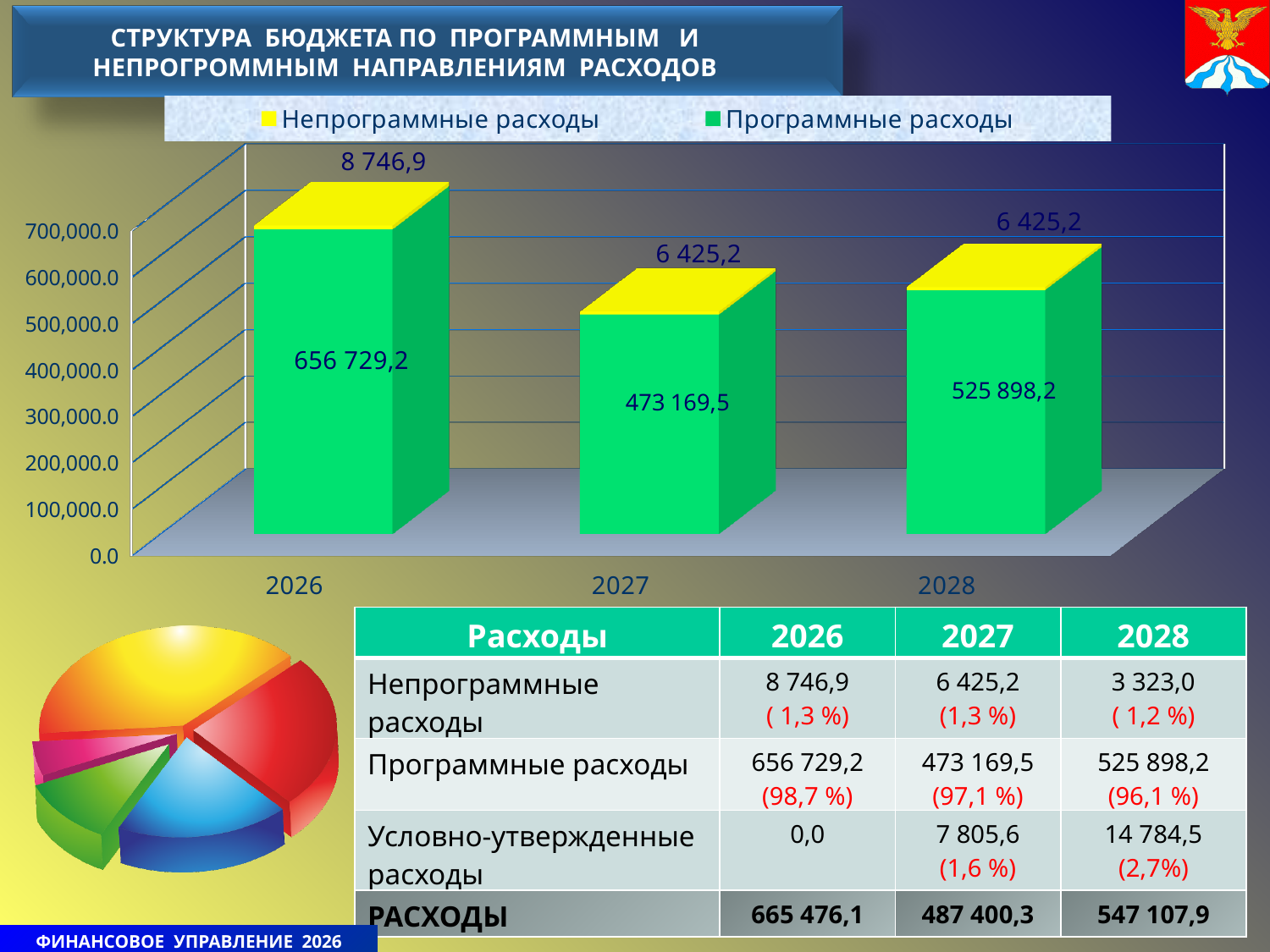
Is the value of Программные расходы for 2027 greater or less than 500,000.0? less What is the difference between Программные расходы in 2026 and 2027 in the bar chart? 183 559,7 What type of chart is shown at the top of the slide? bar chart Which is larger in the bar chart: Программные расходы in 2028 or in 2027? 2028 What is the value of Непрограммные расходы for 2026 in the bar chart? 8 746,9 How many years (categories) are shown on the x axis of the bar chart? 3 In which year is Программные расходы the highest in the bar chart? 2026 What is the value of Программные расходы for 2026 in the bar chart? 656 729,2 What is the value of Программные расходы for 2027 in the bar chart? 473 169,5 In which year is Программные расходы the lowest in the bar chart? 2027 How many series does the legend of the bar chart list? 2 What is the total of the stacked bar for 2026 in the bar chart? 665 476,1